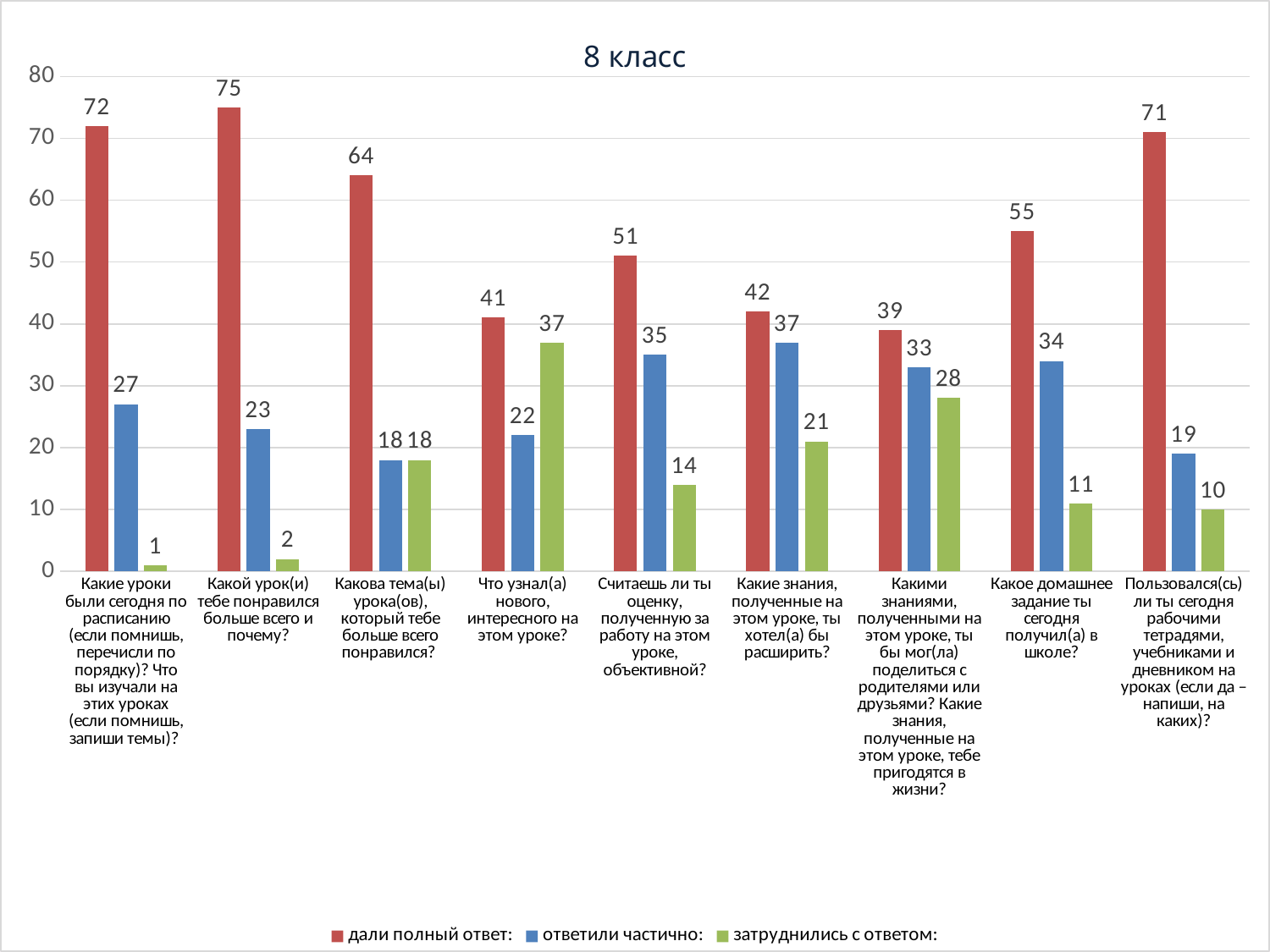
Which category has the lowest value for 'затруднились с ответом'? Какие уроки были сегодня по расписанию (если помнишь, перечисли по порядку)? Что вы изучали на этих уроках (если помнишь, запиши темы)? For 'Какими знаниями, полученными на этом уроке, ты бы мог(ла) поделиться с родителями или друзьями?...', which is larger: 'ответили частично' or 'затруднились с ответом'? ответили частично What is the value of 'ответили частично' for 'Считаешь ли ты оценку, полученную за работу на этом уроке, объективной?' 35 What is the total of the three series for 'Какова тема(ы) урока(ов), который тебе больше всего понравился?' 100 What is the difference between 'дали полный ответ' and 'ответили частично' for 'Пользовался(сь) ли ты сегодня рабочими тетрадями, учебниками и дневником на уроках (если да – напиши, на каких)?' 52 Which category has the highest value for 'дали полный ответ'? Какой урок(и) тебе понравился больше всего и почему? What is the value of 'затруднились с ответом' for 'Что узнал(а) нового, интересного на этом уроке?' 37 What is the title of the chart? 8 класс What is the value of 'дали полный ответ' for 'Какое домашнее задание ты сегодня получил(а) в школе?' 55 How many question categories are shown on the x axis? 9 What type of chart is shown on the slide? bar chart How many series does the legend list? 3